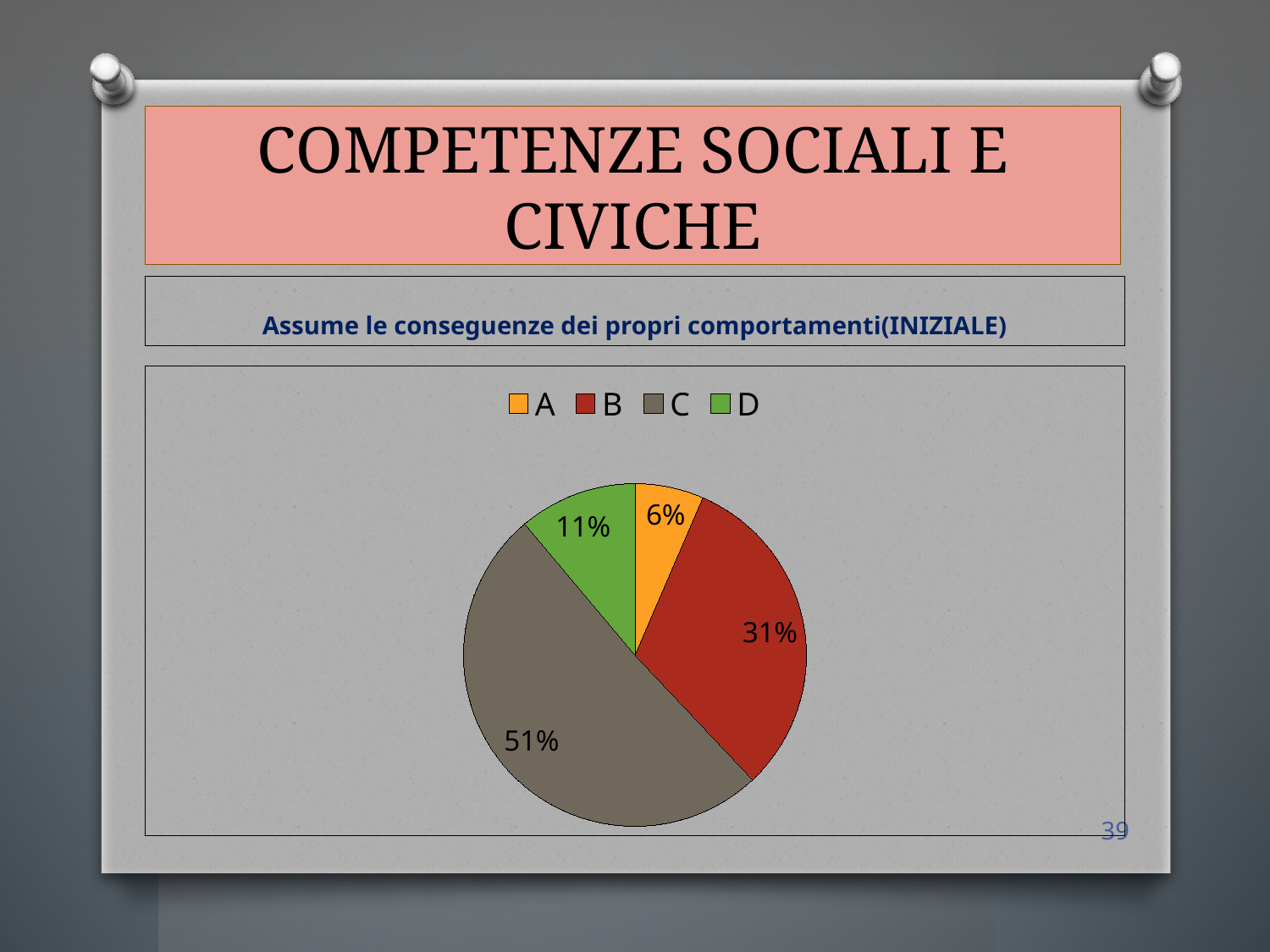
What share of the pie does category A have? 6% What is the difference in percentage points between category C and category B? 20 Which category has the smallest slice of the pie? A What kind of chart is shown on the slide? pie chart How many slices does the pie chart have? 4 What share of the pie does category B have? 31% What share of the pie does category D have? 11% Which category has the largest slice of the pie? C What colour is the slice for category D? green Which is larger, the slice for B or the slice for D? B How many entries does the legend list? 4